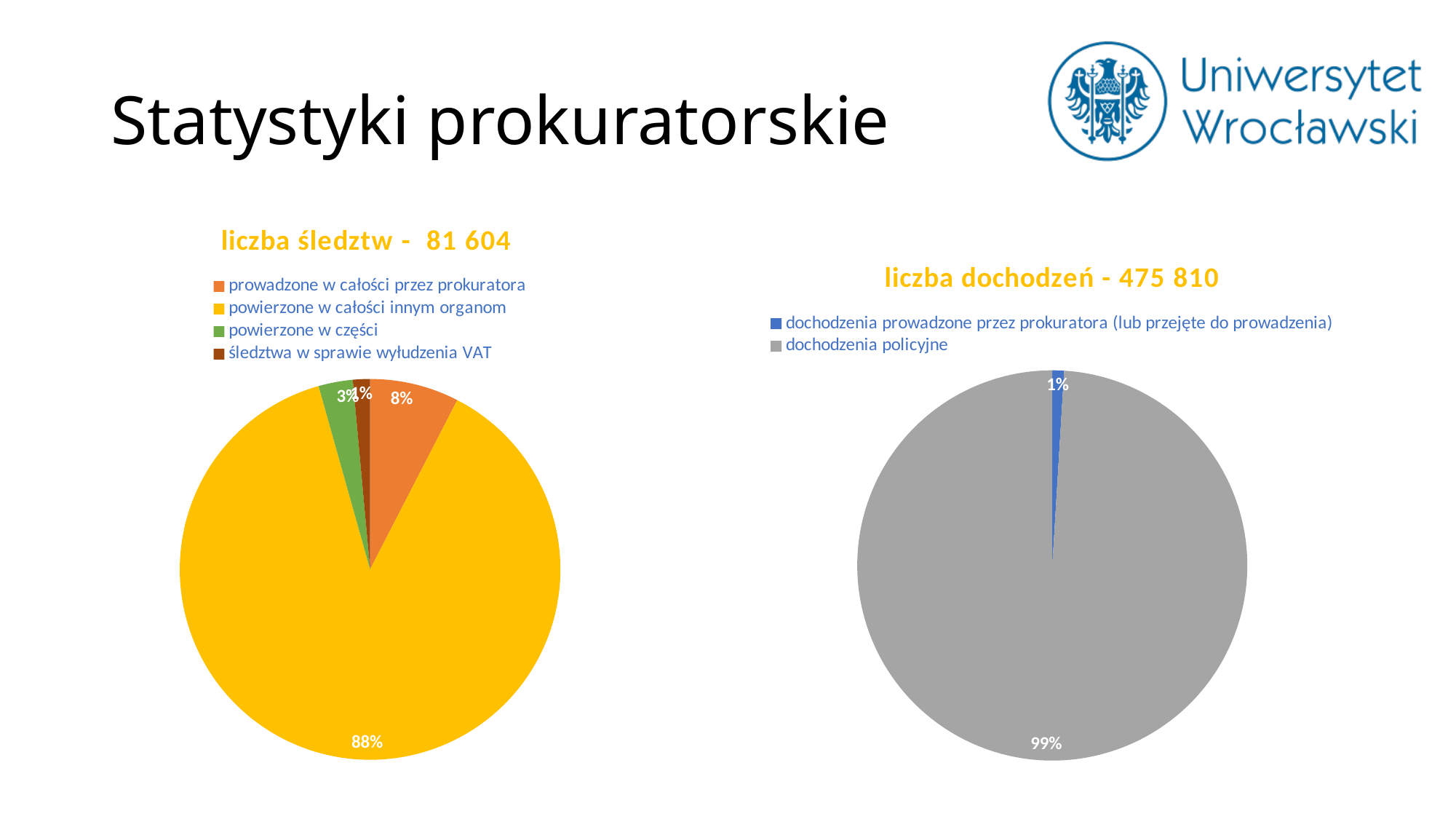
What type of chart is the chart on the right of the slide? pie chart In the chart titled "liczba śledztw - 81 604", what share of the pie is "powierzone w całości innym organom"? 88% In the chart titled "liczba śledztw - 81 604", which category has the largest slice? powierzone w całości innym organom In the chart titled "liczba dochodzeń - 475 810", what share of the pie is "dochodzenia policyjne"? 99% In the chart titled "liczba śledztw - 81 604", what share of the pie is "prowadzone w całości przez prokuratora"? 8% In the chart titled "liczba śledztw - 81 604", what is the difference in percentage points between "powierzone w całości innym organom" and "prowadzone w całości przez prokuratora"? 80 In the chart titled "liczba dochodzeń - 475 810", which category is larger: "dochodzenia policyjne" or "dochodzenia prowadzone przez prokuratora (lub przejęte do prowadzenia)"? dochodzenia policyjne In the chart titled "liczba śledztw - 81 604", how many categories does the legend list? 4 In the chart titled "liczba dochodzeń - 475 810", what colour is the slice for "dochodzenia policyjne"? grey In the chart titled "liczba śledztw - 81 604", which category has the smallest slice? śledztwa w sprawie wyłudzenia VAT